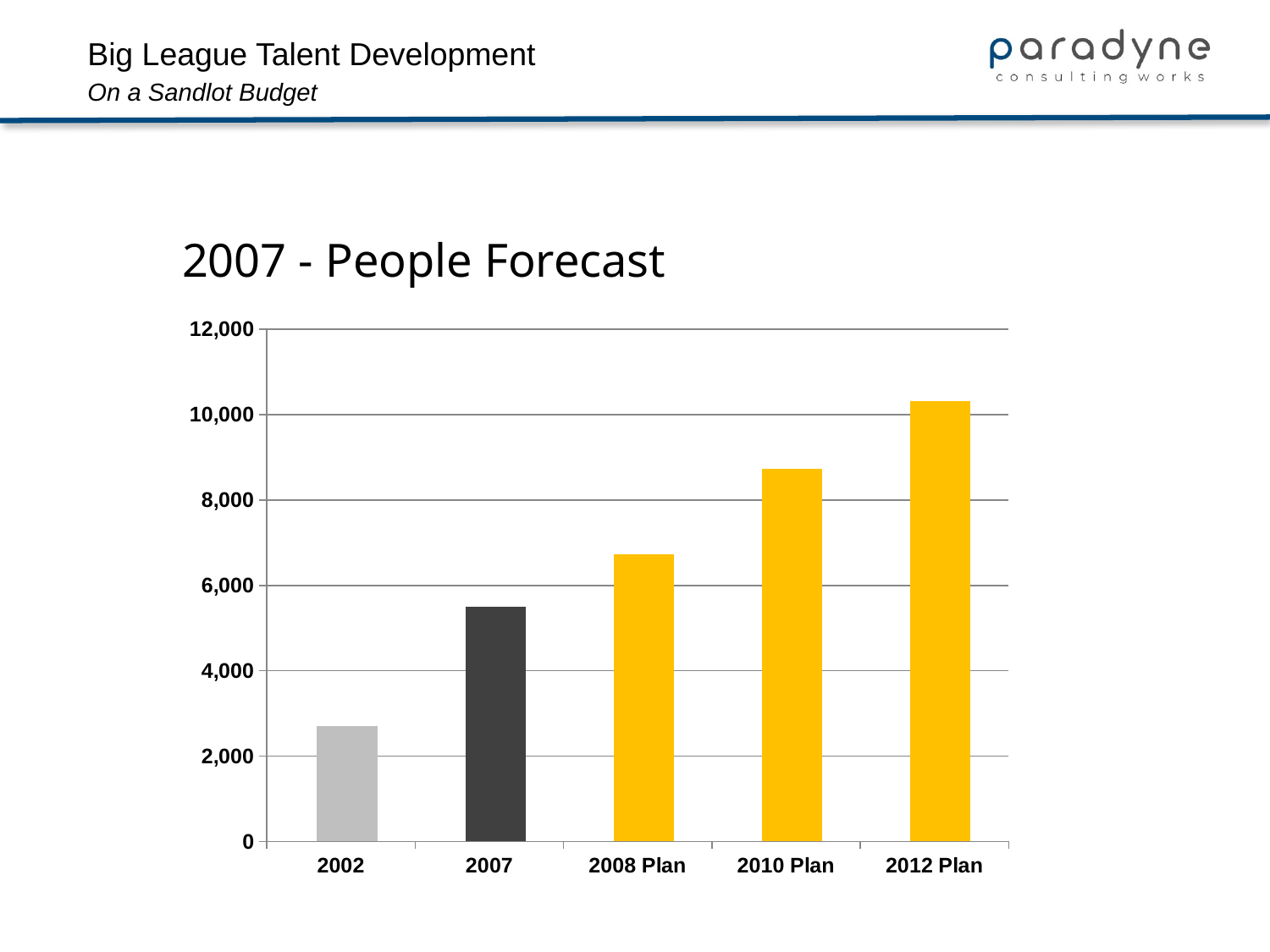
Is the value for 2012 Plan greater or less than 10,000? greater Which is larger, the value for 2007 or the value for 2010 Plan? 2010 Plan What is the title of the chart? 2007 - People Forecast Is the value for 2008 Plan greater or less than 6,000? greater Do the values rise or fall from 2002 to 2012 Plan? rise What kind of chart is shown on the slide? bar chart Is the value for 2010 Plan greater or less than 8,000? greater Which category has the highest value? 2012 Plan Which category has the lowest value? 2002 How many categories are shown on the x axis of the chart? 5